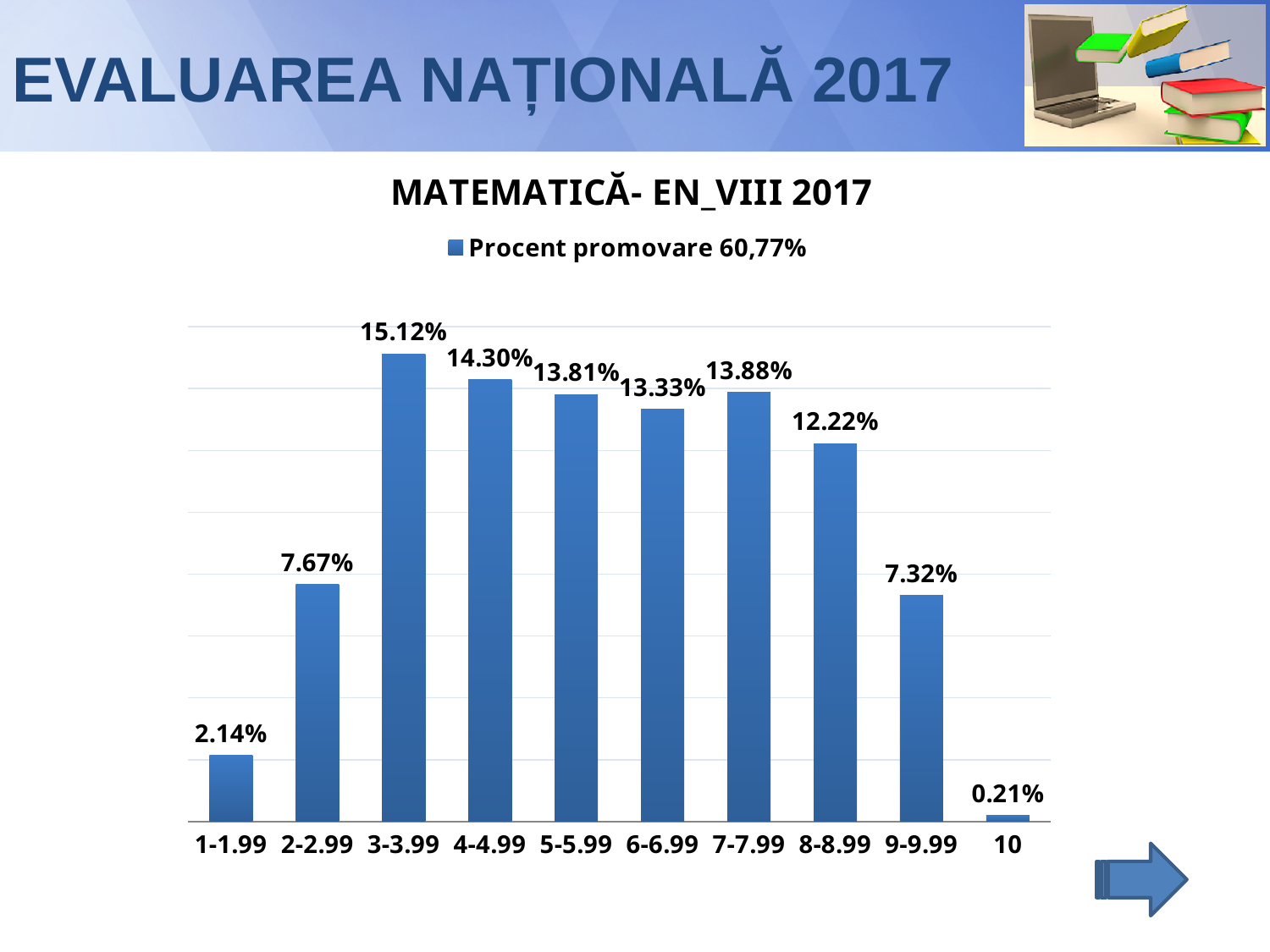
What is the difference between the values for 3-3.99 and 2-2.99? 7.45% What is the value for the 9-9.99 category? 7.32% Which is larger, the value for 4-4.99 or the value for 8-8.99? 4-4.99 What is the title of the chart? MATEMATICĂ- EN_VIII 2017 Which category has the highest value? 3-3.99 How many categories are shown on the x axis? 10 What is the value for the 3-3.99 category? 15.12% What is the legend entry of the chart? Procent promovare 60,77% How many series does the legend list? 1 Which category has the lowest value? 10 What is the value for the 10 category? 0.21% What kind of chart is shown on the slide? bar chart